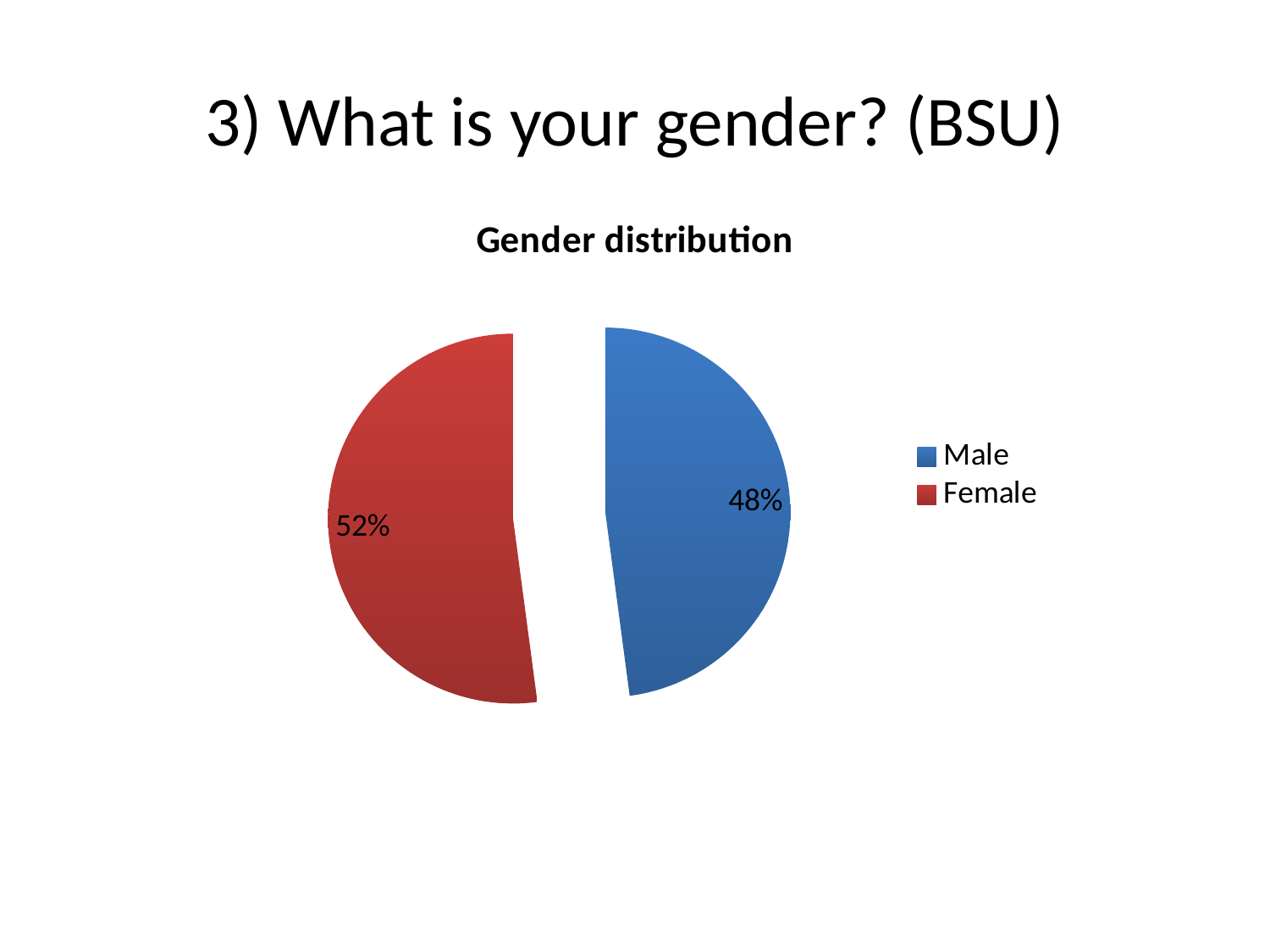
What share of the pie does Male represent? 48% What colour is the Male slice? Blue What is the title of the chart? Gender distribution What is the difference in percentage points between the Female and Male slices? 4% How many slices does the pie chart have? 2 What share of the pie does Female represent? 52% How many entries does the legend list? 2 What is the total of the two slices' percentages? 100% Which is larger, the Male slice or the Female slice? Female Which category has the smallest slice of the pie? Male Which category has the largest slice of the pie? Female What kind of chart is shown on the slide? Pie chart